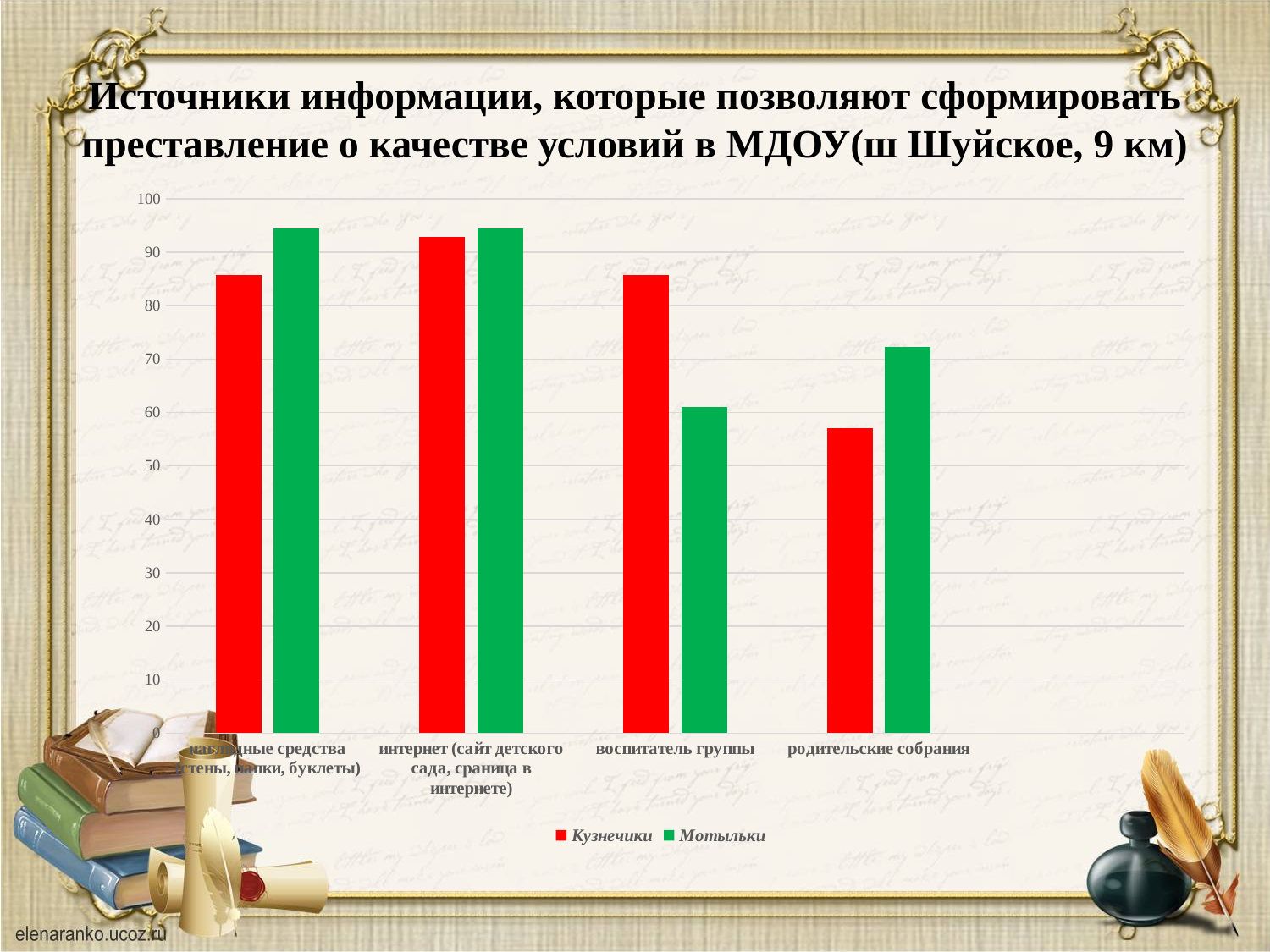
Is the value for Кузнечики in родительские собрания greater or less than 60? less What kind of chart is shown on the slide? bar chart How many series does the legend list? 2 Which category has the lowest value for Кузнечики? родительские собрания Which category has the highest value for Кузнечики? интернет (сайт детского сада, сраница в интернете) Which category has the lowest value for Мотыльки? воспитатель группы How many categories are shown on the x axis? 4 Is the value for Кузнечики in интернет (сайт детского сада, сраница в интернете) greater or less than 90? greater Is the value for Мотыльки in воспитатель группы greater or less than 70? less Which colour represents the Кузнечики series in the legend? red For родительские собрания, which series has the larger value, Кузнечики or Мотыльки? Мотыльки For воспитатель группы, which series has the larger value, Кузнечики or Мотыльки? Кузнечики